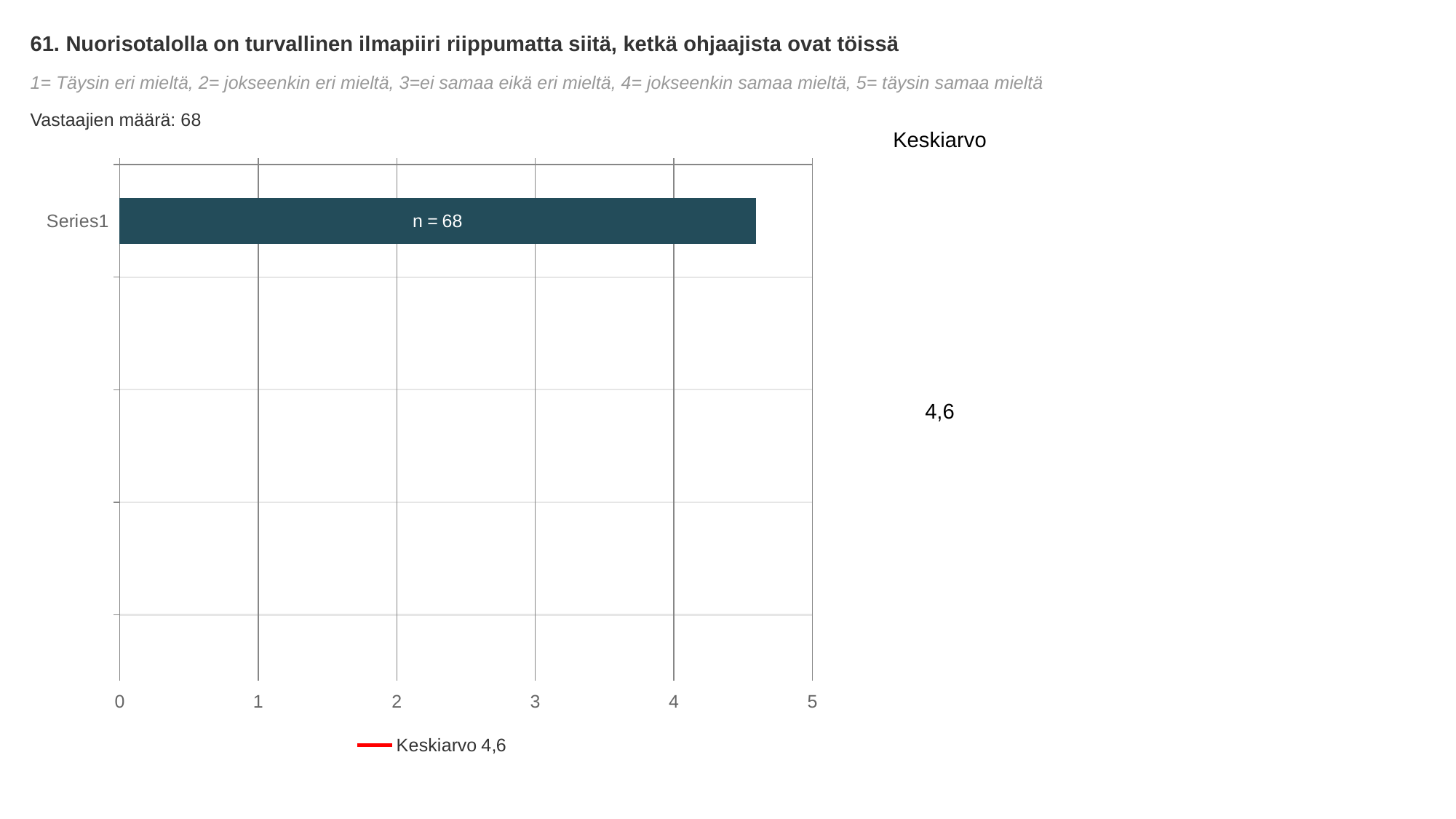
How many bars are plotted in the chart? 1 How many entries does the legend list? 1 What is the data label printed on the Series1 bar? n = 68 What kind of chart is shown on the slide? bar chart What is the category label of the single bar in the chart? Series1 What is the Keskiarvo (mean) value shown on the slide? 4,6 Is the value of the Series1 bar greater or less than 4? greater What is the legend entry text below the chart? Keskiarvo 4,6 What is the highest tick value shown on the horizontal axis? 5 Is the value of the Series1 bar greater or less than 5? less What is the number of respondents (Vastaajien määrä) stated on the slide? 68